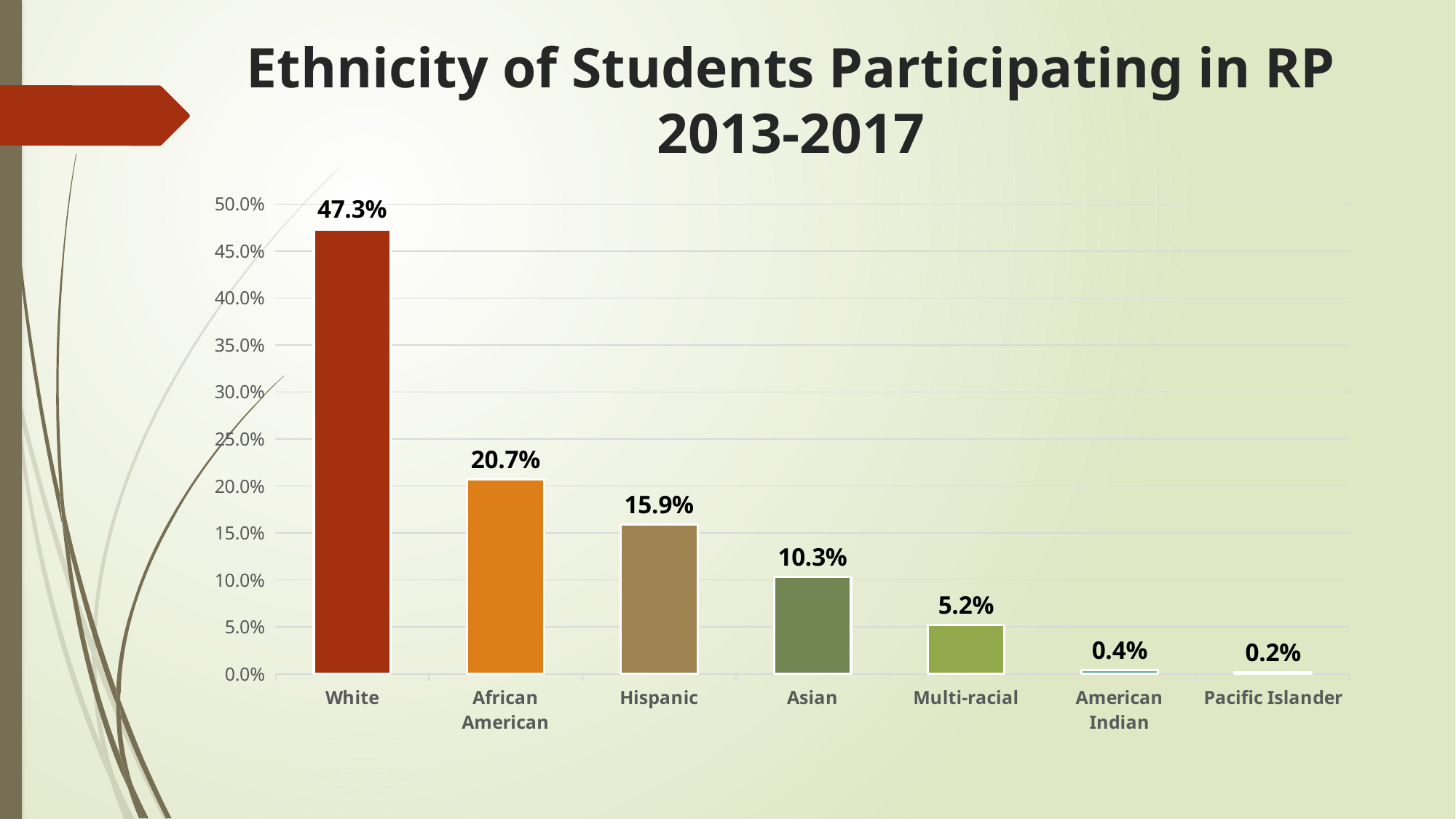
What kind of chart is shown on the slide? Bar chart Is the value for African American students greater or less than 25.0%? less How many ethnicity categories are shown on the chart? 7 What is the value shown for Hispanic students? 15.9% What percentage is shown for Multi-racial students? 5.2% Which ethnicity has the highest percentage of participating students? White What percentage of students participating in RP 2013-2017 were White? 47.3% Which ethnicity has the lowest percentage of participating students? Pacific Islander Do the values rise or fall moving from left to right along the x axis? Fall Which is larger, the percentage for Hispanic students or for Asian students? Hispanic What is the difference between the percentages for White and African American students? 26.6% What is the difference between the percentages for Asian and Multi-racial students? 5.1%